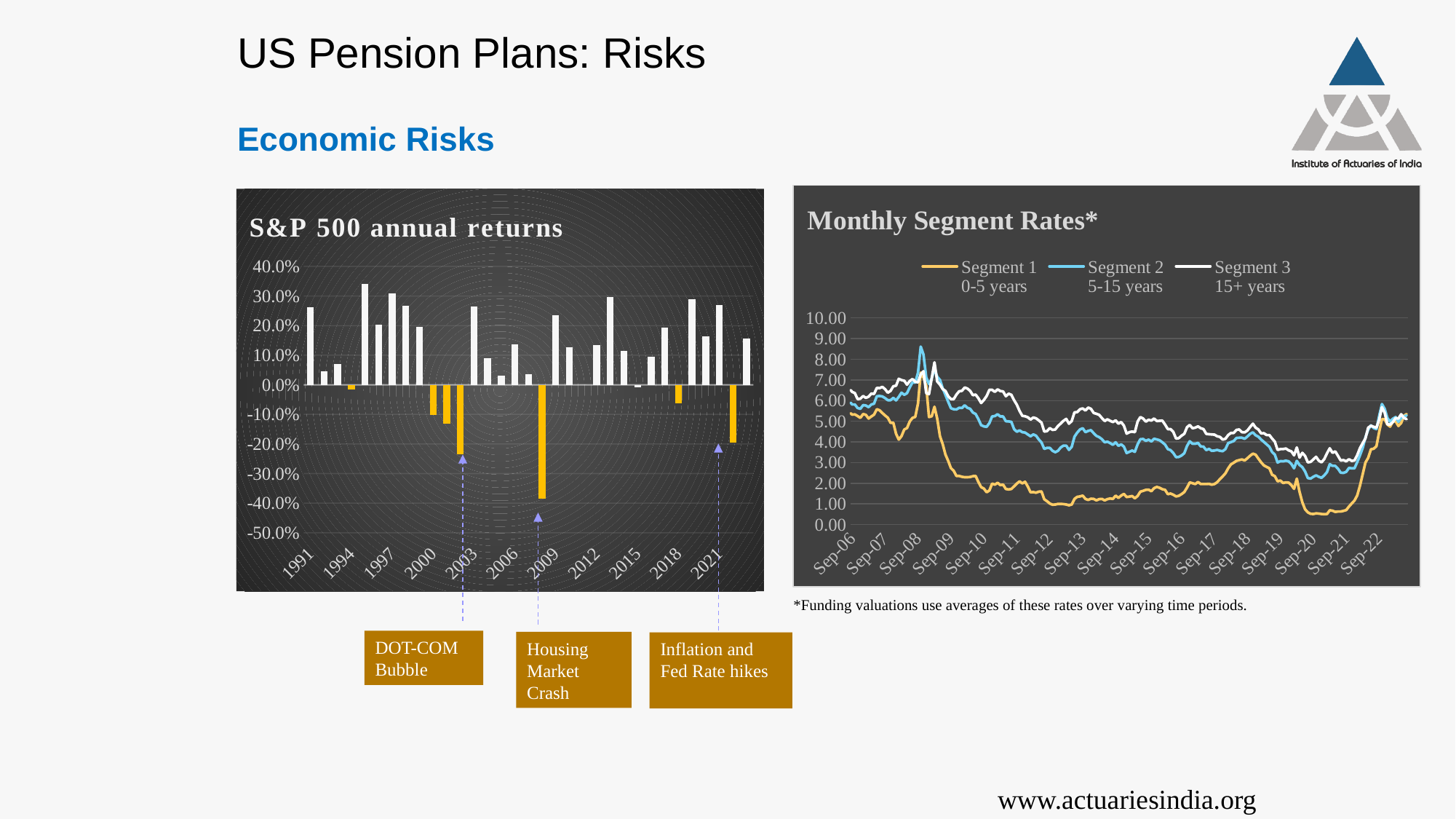
In the "Monthly Segment Rates*" chart, which segment does the legend say covers 15+ years? Segment 3 How many x-axis labels are shown on the "Monthly Segment Rates*" chart? 17 In the "S&P 500 annual returns" chart, which event label is attached to the lowest bar? Housing Market Crash In the "Monthly Segment Rates*" chart, which is larger at Sep-20: Segment 1 or Segment 3? Segment 3 In the "Monthly Segment Rates*" chart, is the value of Segment 1 at Sep-20 greater or less than 1.00? less How many year labels are shown on the x axis of the "S&P 500 annual returns" chart? 11 In the "S&P 500 annual returns" chart, is the lowest bar greater or less than -30.0%? less What kind of chart is the "Monthly Segment Rates*" chart? line chart In the "Monthly Segment Rates*" chart, is the value of Segment 3 at Sep-06 greater or less than 5.00? greater In the "Monthly Segment Rates*" chart, does Segment 1 rise or fall between Sep-08 and Sep-12? fall How many series does the legend of the "Monthly Segment Rates*" chart list? 3 What kind of chart is the "S&P 500 annual returns" chart? bar chart